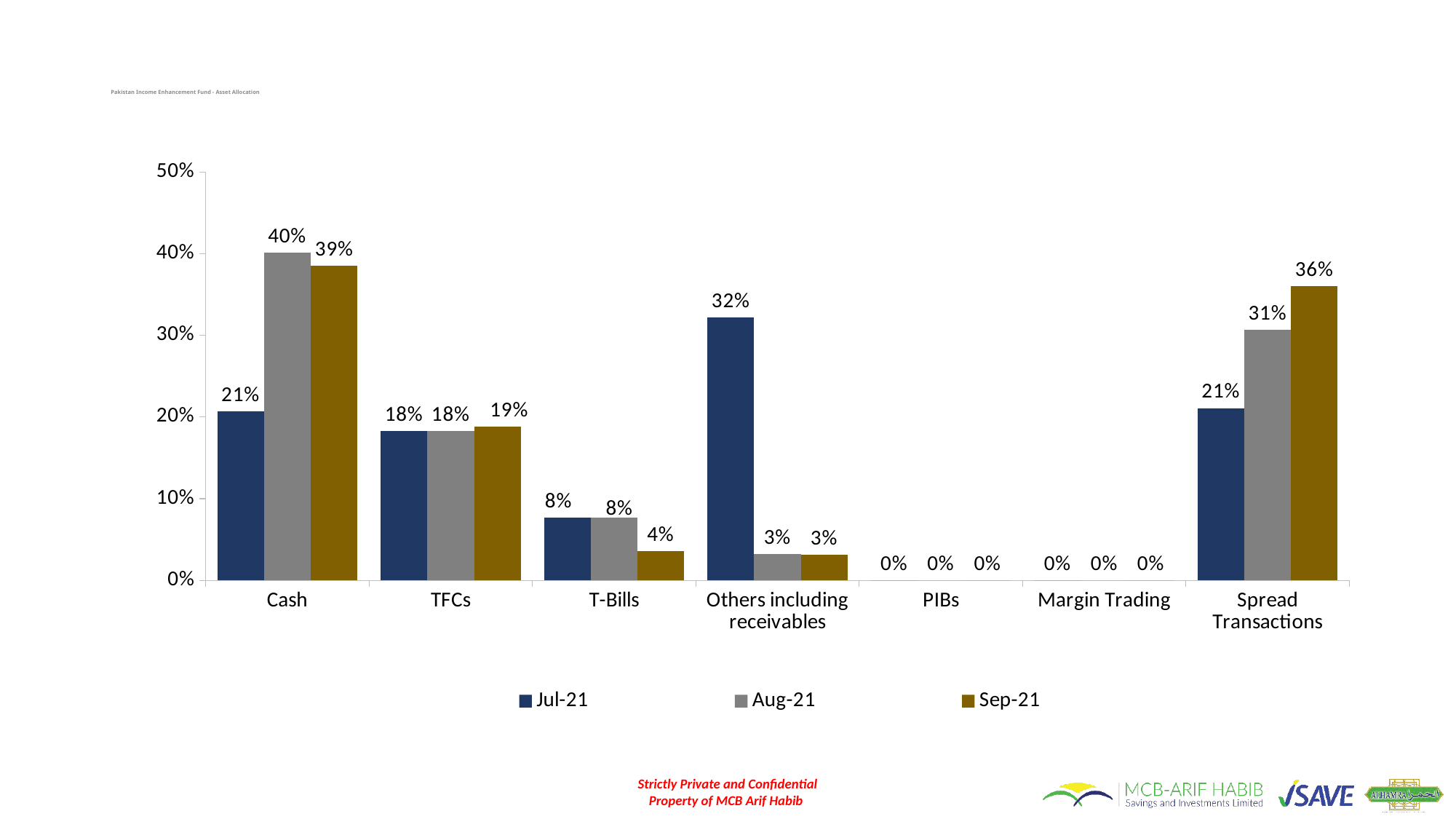
Do the values for Spread Transactions rise or fall from Jul-21 to Sep-21? Rise Which category has the highest Jul-21 value? Others including receivables What is the Jul-21 value for Others including receivables? 32% What is the Sep-21 value for T-Bills? 4% What is the difference between the Jul-21 and Aug-21 values for Cash? 19% Which is larger for Spread Transactions: the Aug-21 value or the Sep-21 value? Sep-21 How many categories are shown on the x axis? 7 How many series does the legend list? 3 What is the Aug-21 value for Cash? 40% What kind of chart is shown on the slide? Bar chart Which category has the highest Sep-21 value? Cash What is the Sep-21 value for Spread Transactions? 36%